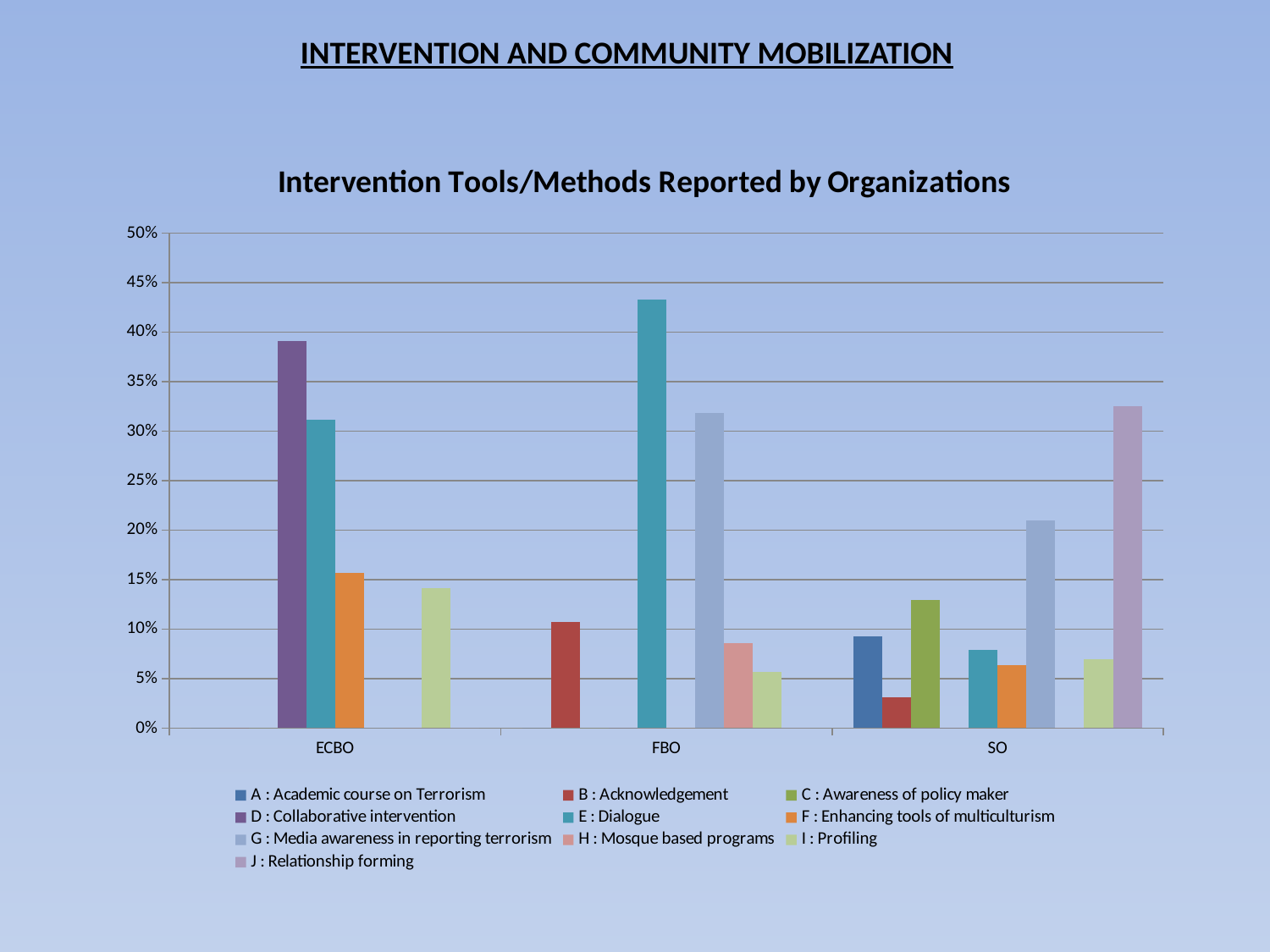
Which is larger: the value for E : Dialogue in ECBO or in FBO? FBO Which intervention tool has the highest value for SO? J : Relationship forming Is the value for D : Collaborative intervention in the ECBO category greater or less than 35%? greater Which intervention tool has the highest value for ECBO? D : Collaborative intervention What kind of chart is shown on the slide? Bar chart What is the title of the chart? Intervention Tools/Methods Reported by Organizations How many series does the legend list? 10 Which intervention tool has the highest value for FBO? E : Dialogue Is the value for G : Media awareness in reporting terrorism in the SO category greater or less than 25%? less How many organization categories are shown on the x axis? 3 Is the value for E : Dialogue in the FBO category greater or less than 40%? greater